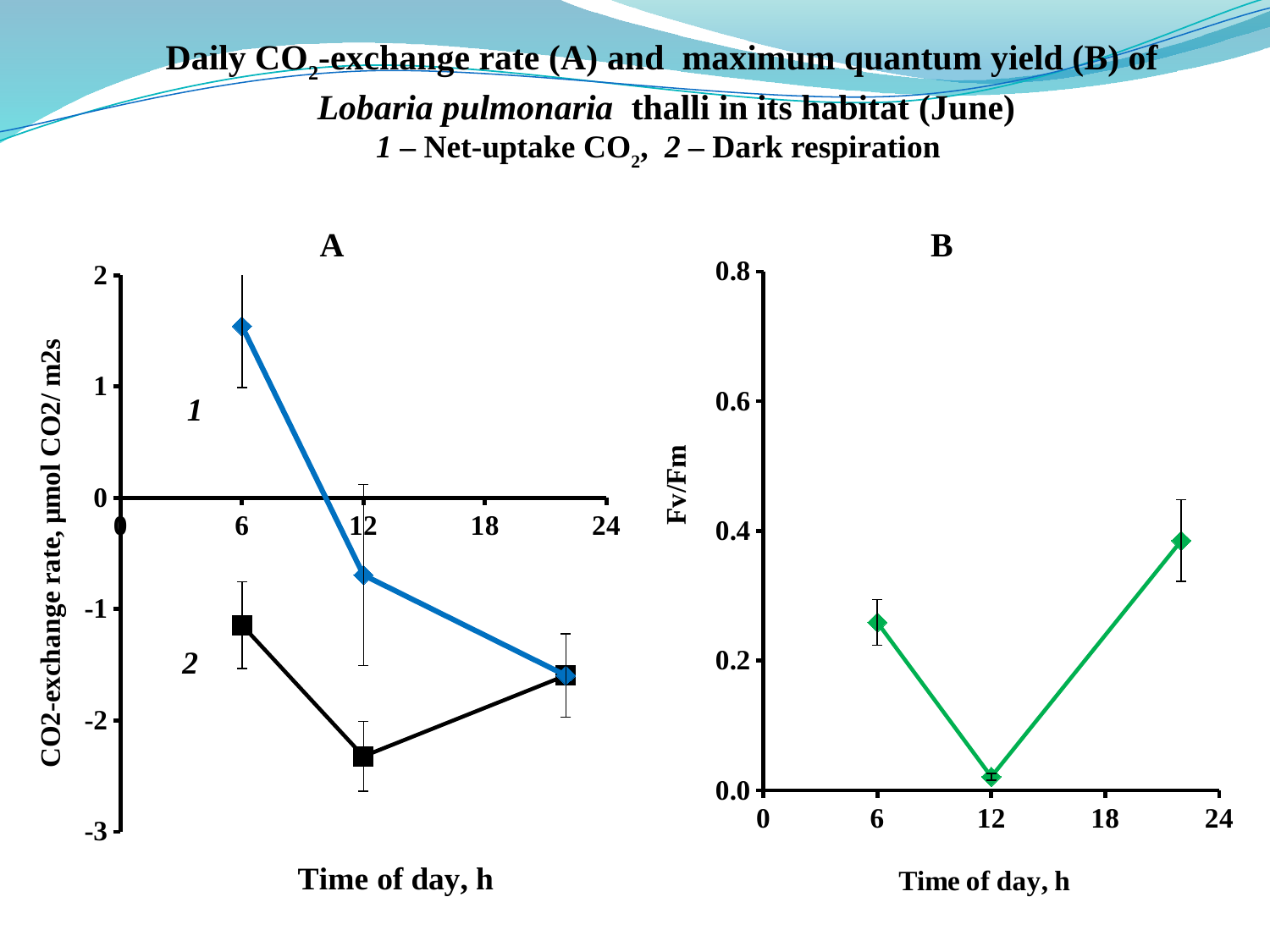
In chart A, is the value of series 1 (Net-uptake CO2) at 12 h greater or less than 0? less In chart A, is the value of series 2 (Dark respiration) at 12 h greater or less than -2? less What is the y-axis label of chart B? Fv/Fm In chart A, at 6 h, which series has the larger value, 1 (Net-uptake CO2) or 2 (Dark respiration)? 1 (Net-uptake CO2) What kind of chart is chart A? line chart In chart B, how many data points are plotted? 3 In chart A, does series 1 (Net-uptake CO2) rise or fall across the day from 6 h onward? fall In chart B, is the Fv/Fm value at 6 h greater or less than 0.2? greater In chart B, does Fv/Fm rise or fall between 6 h and 12 h? fall In chart B, at which time of day is Fv/Fm lowest? 12